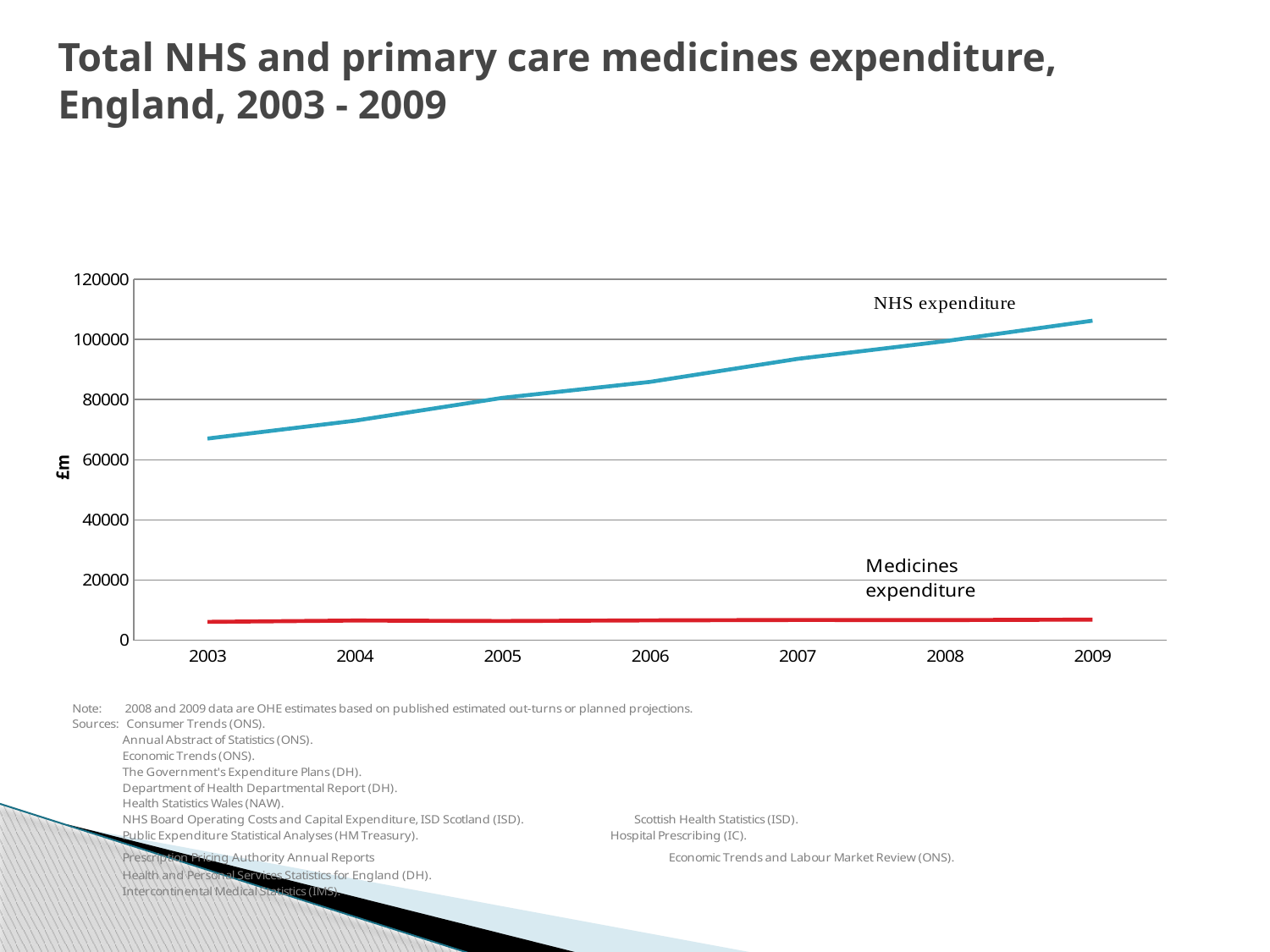
Does NHS expenditure rise or fall from 2003 to 2009? rise In which year is NHS expenditure lowest? 2003 What is the label on the y axis? £m Is NHS expenditure in 2003 greater or less than 60000? greater Which is larger in 2009, NHS expenditure or Medicines expenditure? NHS expenditure How many series are plotted on the chart? 2 Is NHS expenditure in 2007 greater or less than 100000? less Is NHS expenditure in 2009 greater or less than 100000? greater How many years are shown along the x axis? 7 What kind of chart is shown on the slide? line chart In which year is NHS expenditure highest? 2009